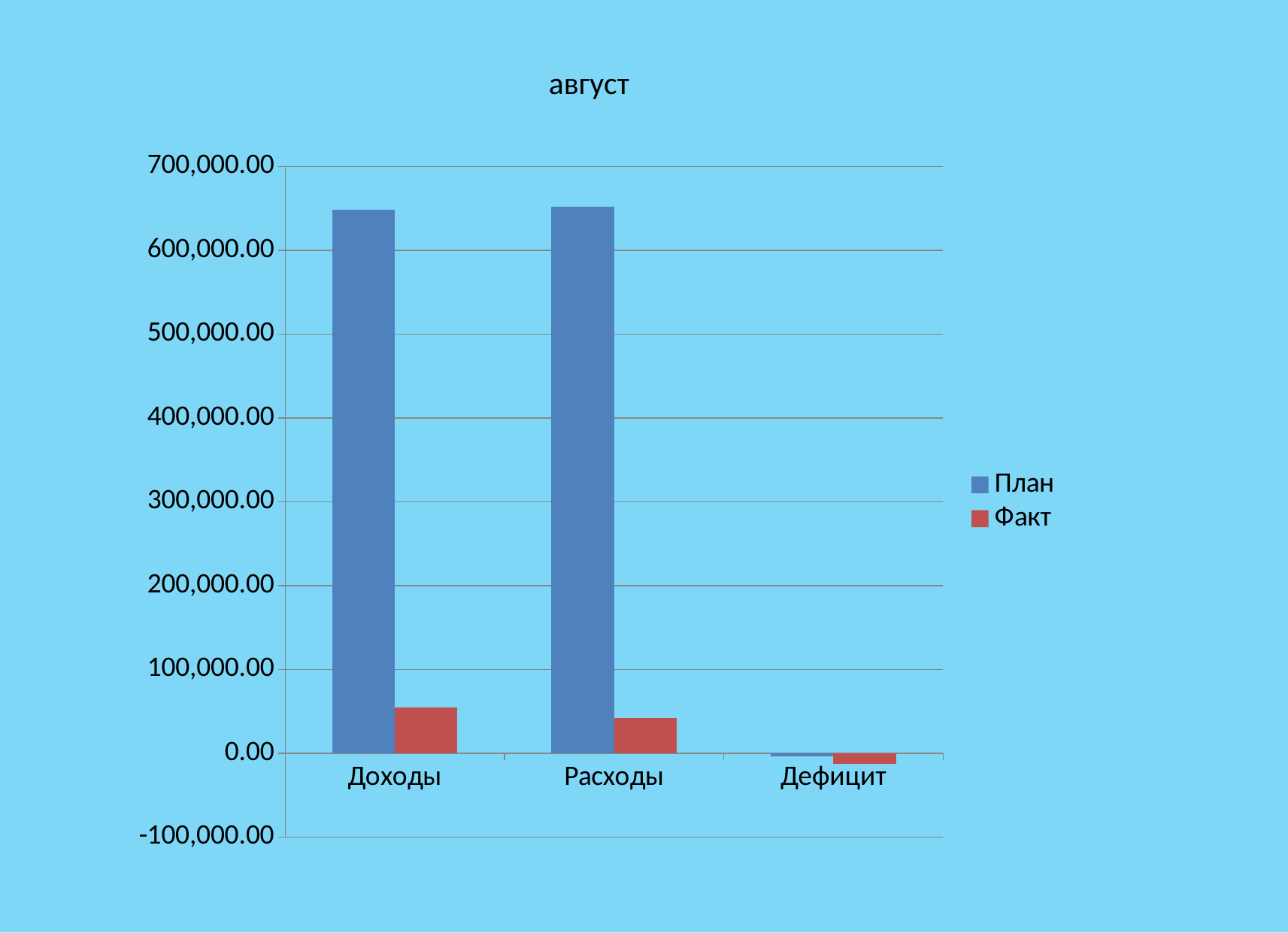
Is the План value for Доходы greater or less than 600,000.00? greater Which category has the lowest План value? Дефицит Is the План value for Расходы greater or less than 700,000.00? less Which series is shown in red? Факт Is the Факт value for Доходы greater or less than 100,000.00? less How many categories are shown on the x axis? 3 What is the title of the chart? август What kind of chart is shown on the slide? bar chart For Доходы, which is larger: План or Факт? План Which category has the highest Факт value? Доходы How many series does the legend list? 2